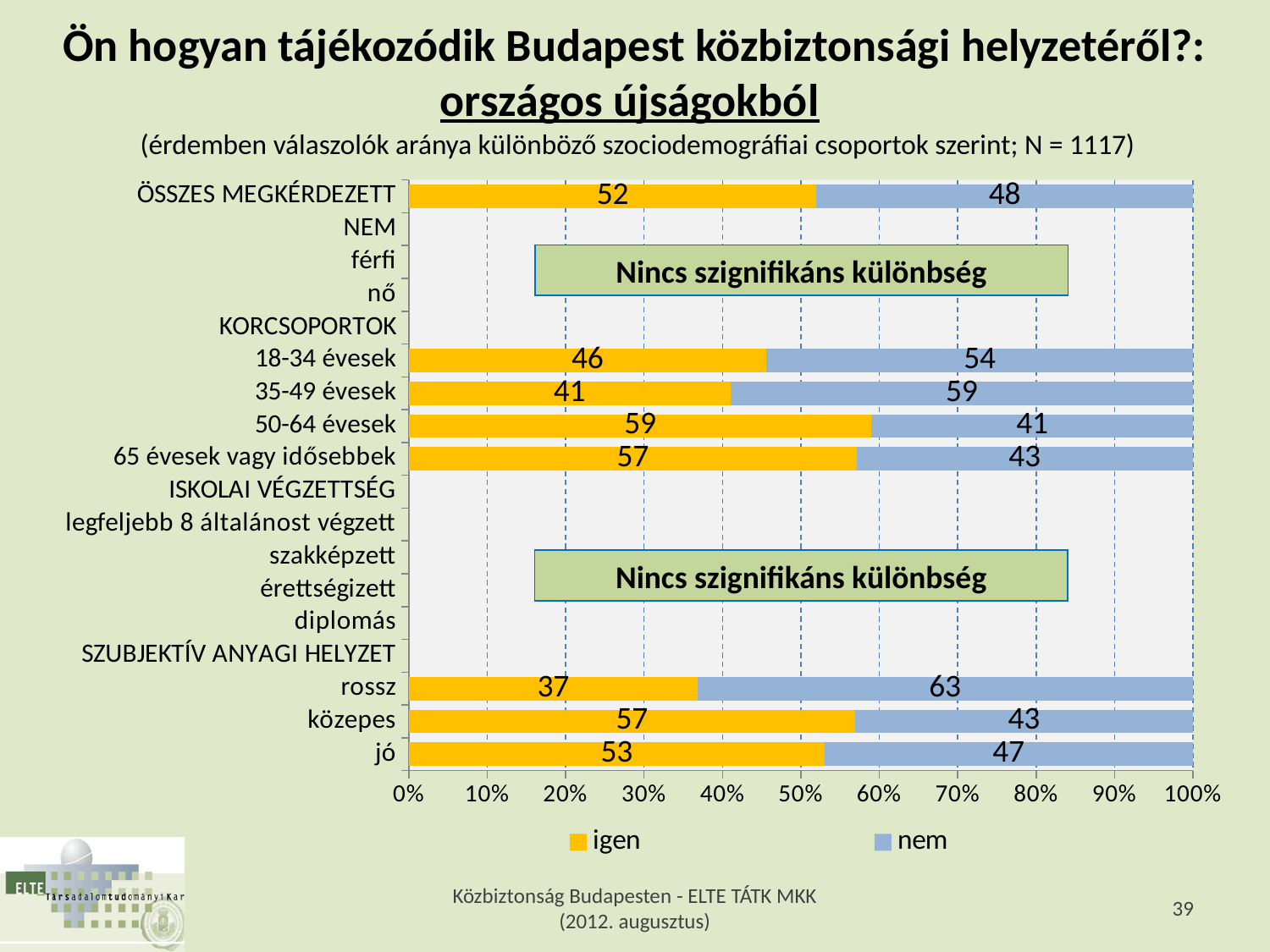
What is the difference between the 'nem' value for 'rossz' and the 'nem' value for 'jó'? 16 Which colour represents the 'igen' series in the chart? Yellow Which is larger: the 'igen' value for 18-34 évesek or the 'igen' value for 65 évesek vagy idősebbek? 65 évesek vagy idősebbek What kind of chart is shown on the slide? Stacked bar chart Among the subjective financial situation categories (rossz, közepes, jó), which has the lowest 'igen' value? rossz What is the 'igen' value for the 'rossz' category? 37 What is the 'igen' value for ÖSSZES MEGKÉRDEZETT? 52 What is the 'nem' value for 35-49 évesek? 59 What text appears in the two boxes placed over the NEM and ISKOLAI VÉGZETTSÉG sections of the chart? Nincs szignifikáns különbség What is the total of the stacked bar for 'közepes'? 100 How many series does the legend list? 2 Among the age groups (18-34, 35-49, 50-64, 65 or older), which has the highest 'igen' value? 50-64 évesek